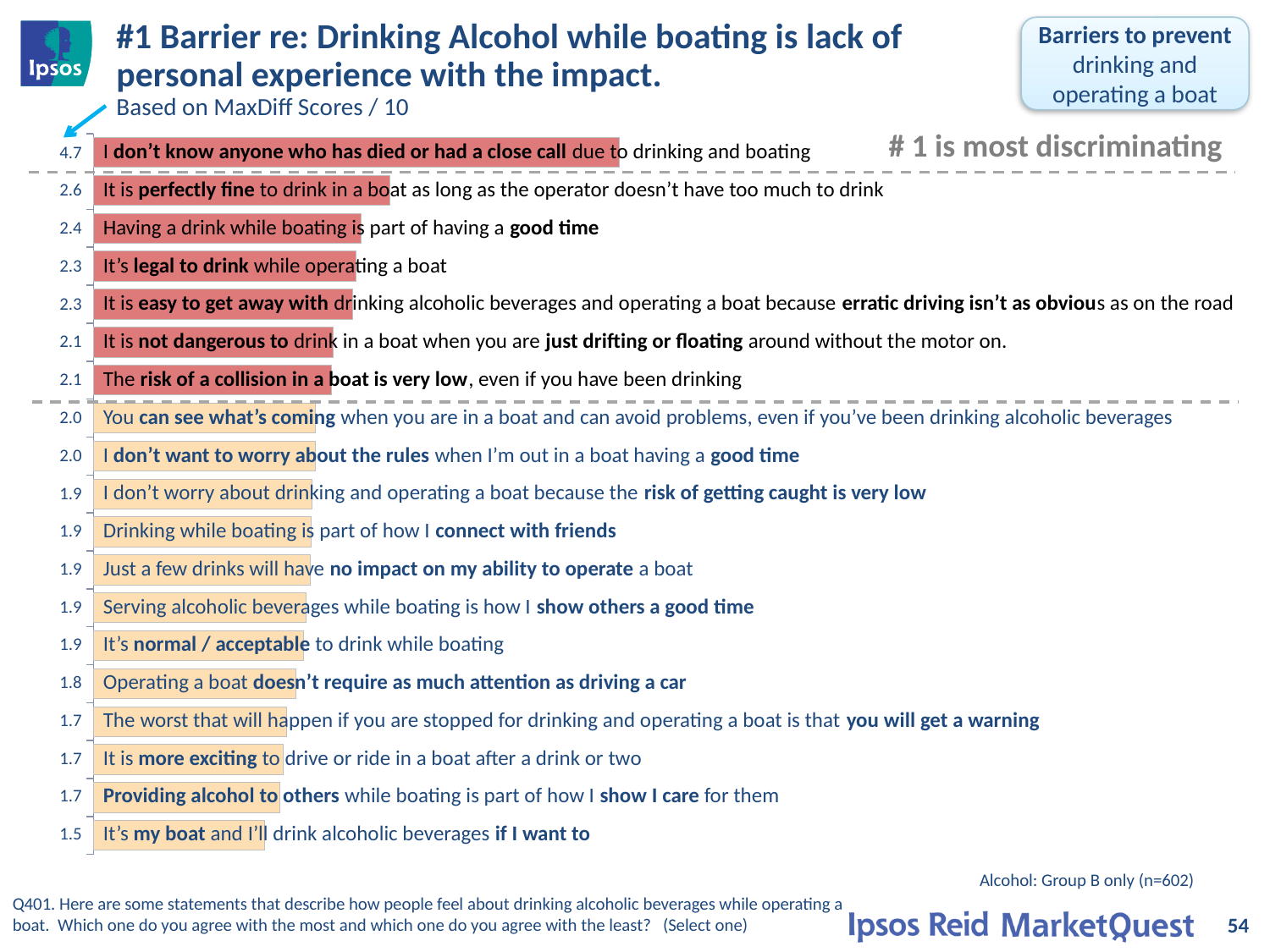
What is the MaxDiff score for "It's my boat and I'll drink alcoholic beverages if I want to"? 1.5 What type of chart is shown on the slide? Bar chart What score is shown for "Operating a boat doesn't require as much attention as driving a car"? 1.8 Which statement has the lowest MaxDiff score? It's my boat and I'll drink alcoholic beverages if I want to What is the score for the statement "It is more exciting to drive or ride in a boat after a drink or two"? 1.7 What is the score for "Having a drink while boating is part of having a good time"? 2.4 Which has a higher score: "It is perfectly fine to drink in a boat as long as the operator doesn't have too much to drink" or "It's normal / acceptable to drink while boating"? It is perfectly fine to drink in a boat as long as the operator doesn't have too much to drink What is the MaxDiff score for the statement "It's legal to drink while operating a boat"? 2.3 Which statement has the highest MaxDiff score? I don't know anyone who has died or had a close call due to drinking and boating How many statements are plotted in the chart? 19 Do the scores increase or decrease going from the top statement to the bottom statement? Decrease What is the difference between the highest score (4.7) and the second-highest score (2.6)? 2.1